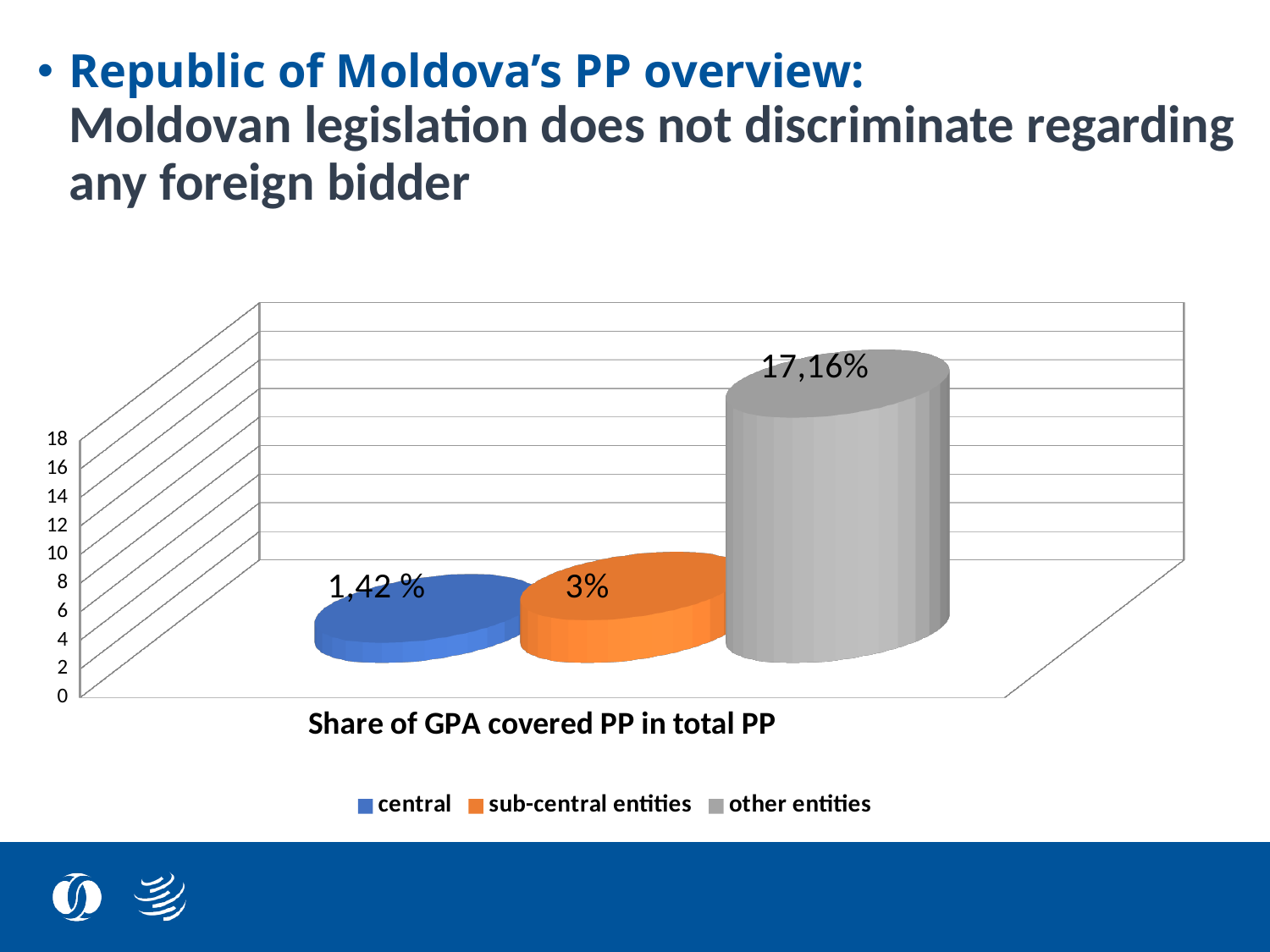
Is the value for other entities greater or less than 16? greater What is the difference between the value for other entities and the value for sub-central entities? 14,16% What is the value shown for other entities? 17,16% What kind of chart is shown on the slide? bar chart What is the value shown for sub-central entities? 3% Is the value for sub-central entities greater or less than 4? less Which series has the highest value? other entities Which series has the lowest value? central What is the value shown for central? 1,42 % How many series does the legend list? 3 What is the category label shown below the bars? Share of GPA covered PP in total PP Which is larger, the value for sub-central entities or the value for central? sub-central entities